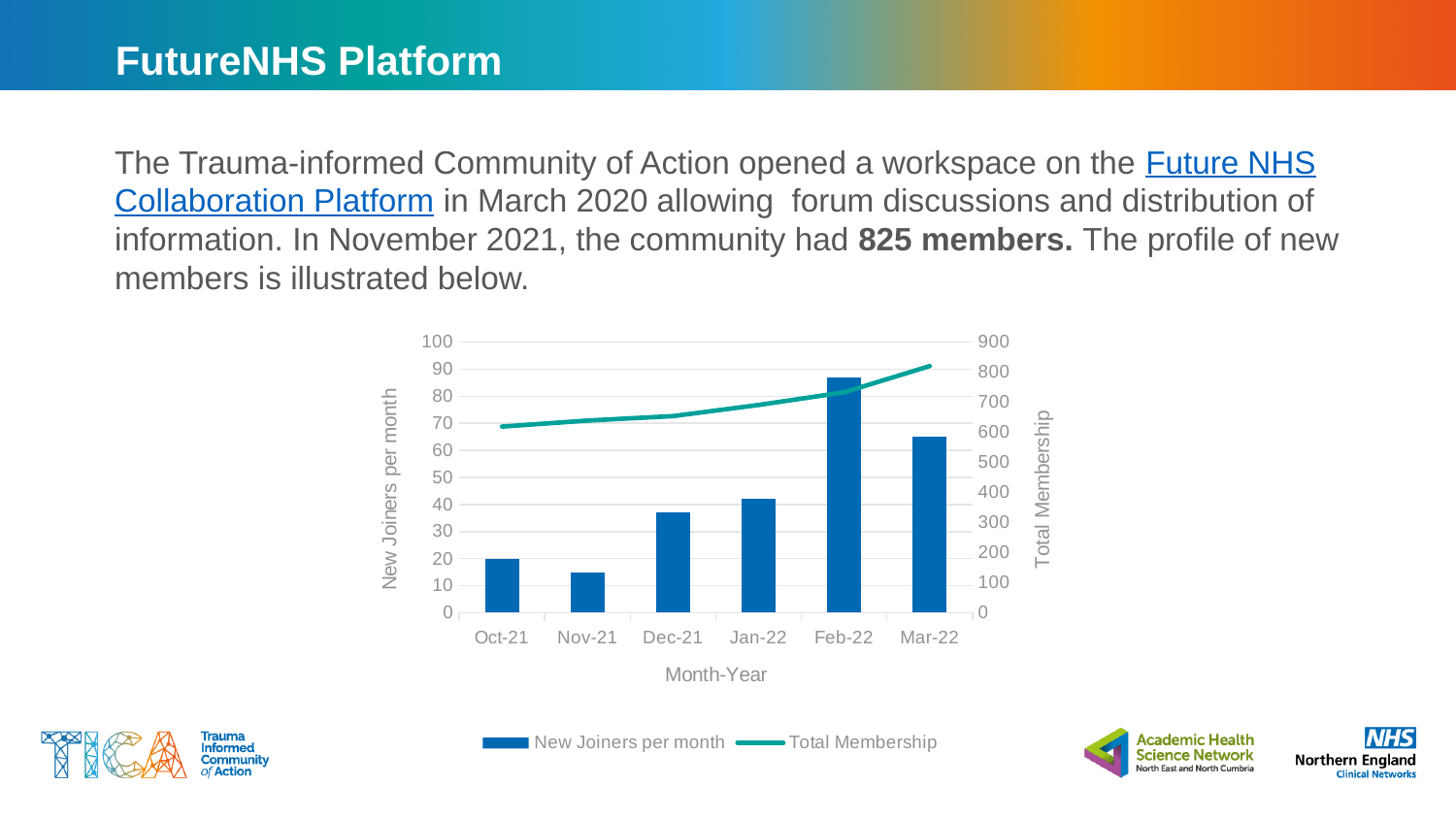
Is the total membership in Oct-21 greater or less than 700? less Is the value for new joiners per month in Nov-21 greater or less than 20? less Is the value for new joiners per month in Mar-22 greater or less than 60? greater How many series does the chart legend list? 2 Which month has the lowest number of new joiners per month? Nov-21 Which month has the highest number of new joiners per month? Feb-22 How many months are shown on the x axis of the chart? 6 What is the title of the x axis of the chart? Month-Year Which month has more new joiners per month, Jan-22 or Mar-22? Mar-22 Does the total membership line rise or fall from Oct-21 to Mar-22? rise